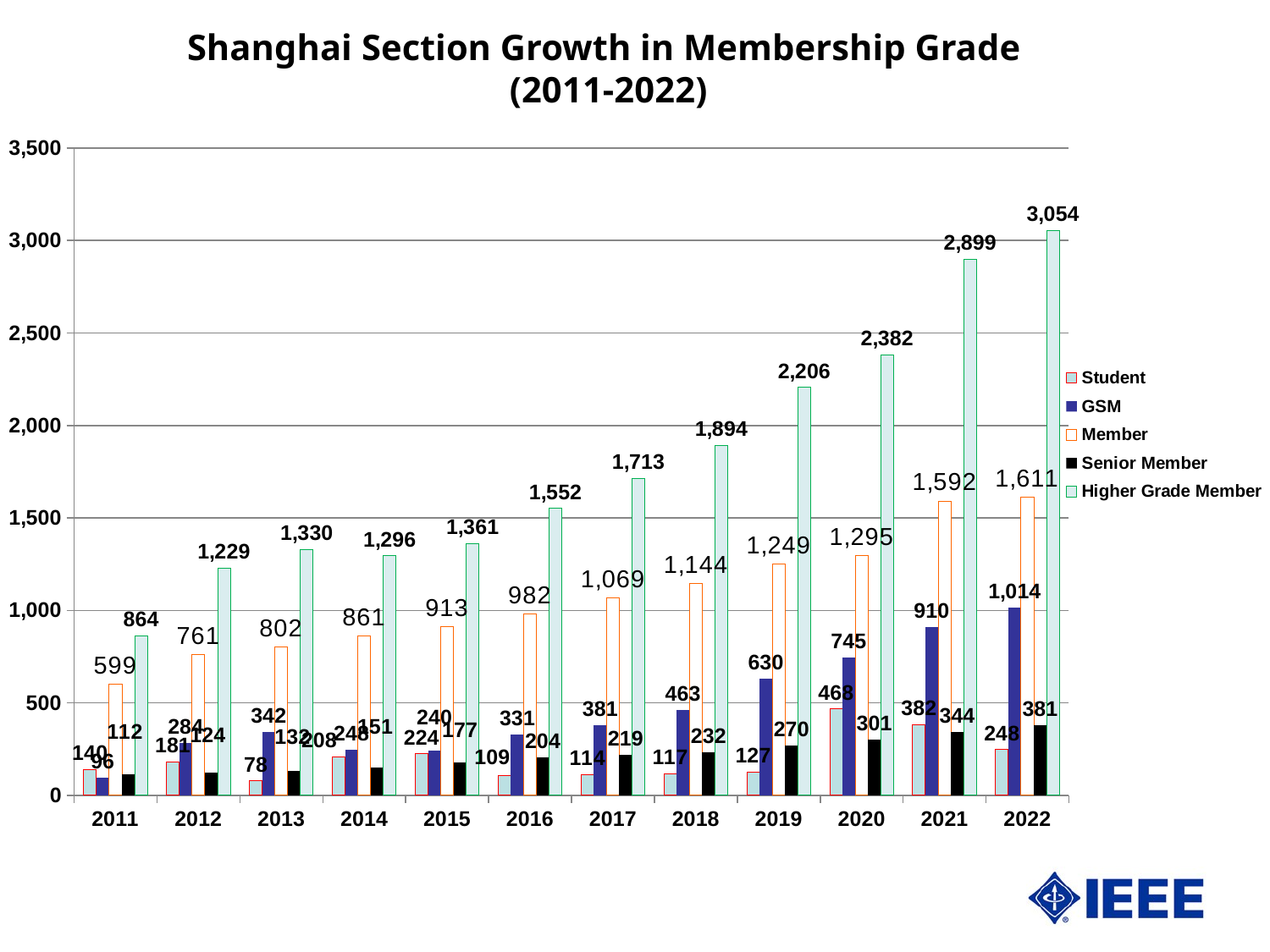
How many series does the legend list? 5 What is the value for Member in 2016? 982 What is the value for Higher Grade Member in 2022? 3,054 Which is larger in 2022, the GSM value or the Member value? Member What is the value for GSM in 2019? 630 What is the value for Student in 2020? 468 Is the Member value in 2021 greater or less than 1,500? greater What is the difference between the Higher Grade Member values in 2022 and 2021? 155 How many years are shown on the x axis? 12 Does the Higher Grade Member value rise or fall from 2011 to 2022? rise In which year is the Higher Grade Member value highest? 2022 In which year is the Student value lowest? 2013